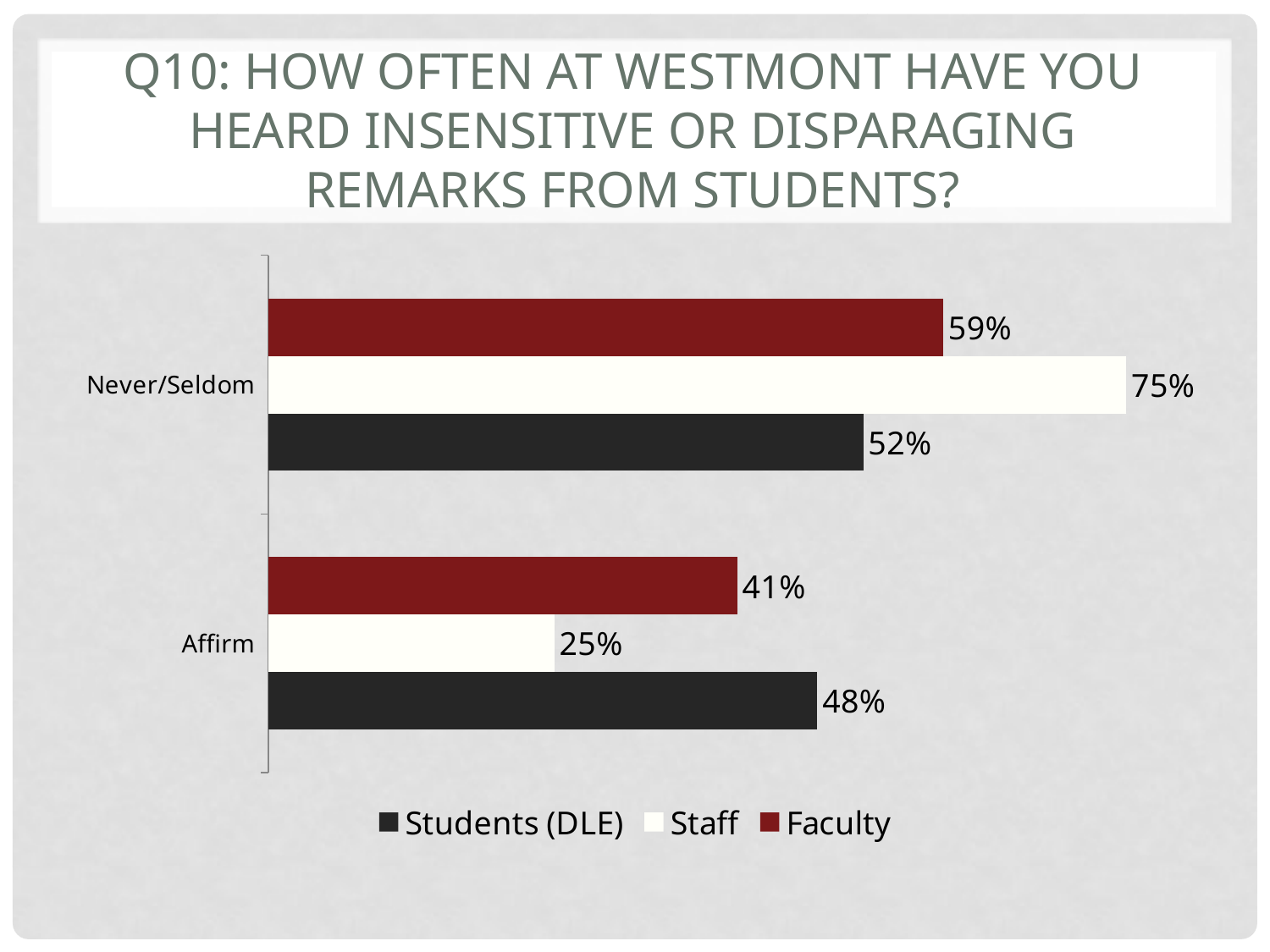
What percentage of Students (DLE) answered Affirm? 48% What is the difference between the Staff and Students (DLE) values for Never/Seldom? 23% What percentage of Staff answered Affirm? 25% How many series does the legend list? 3 Which group has the highest value for Never/Seldom? Staff What kind of chart is shown on the slide? Bar chart Which is larger: the Faculty value for Affirm or the Students (DLE) value for Affirm? Students (DLE) What percentage of Staff answered Never/Seldom? 75% Which group has the lowest value for Affirm? Staff How many categories are shown on the chart? 2 What is the difference between the Faculty and Staff values for Affirm? 16% What percentage of Faculty answered Never/Seldom? 59%